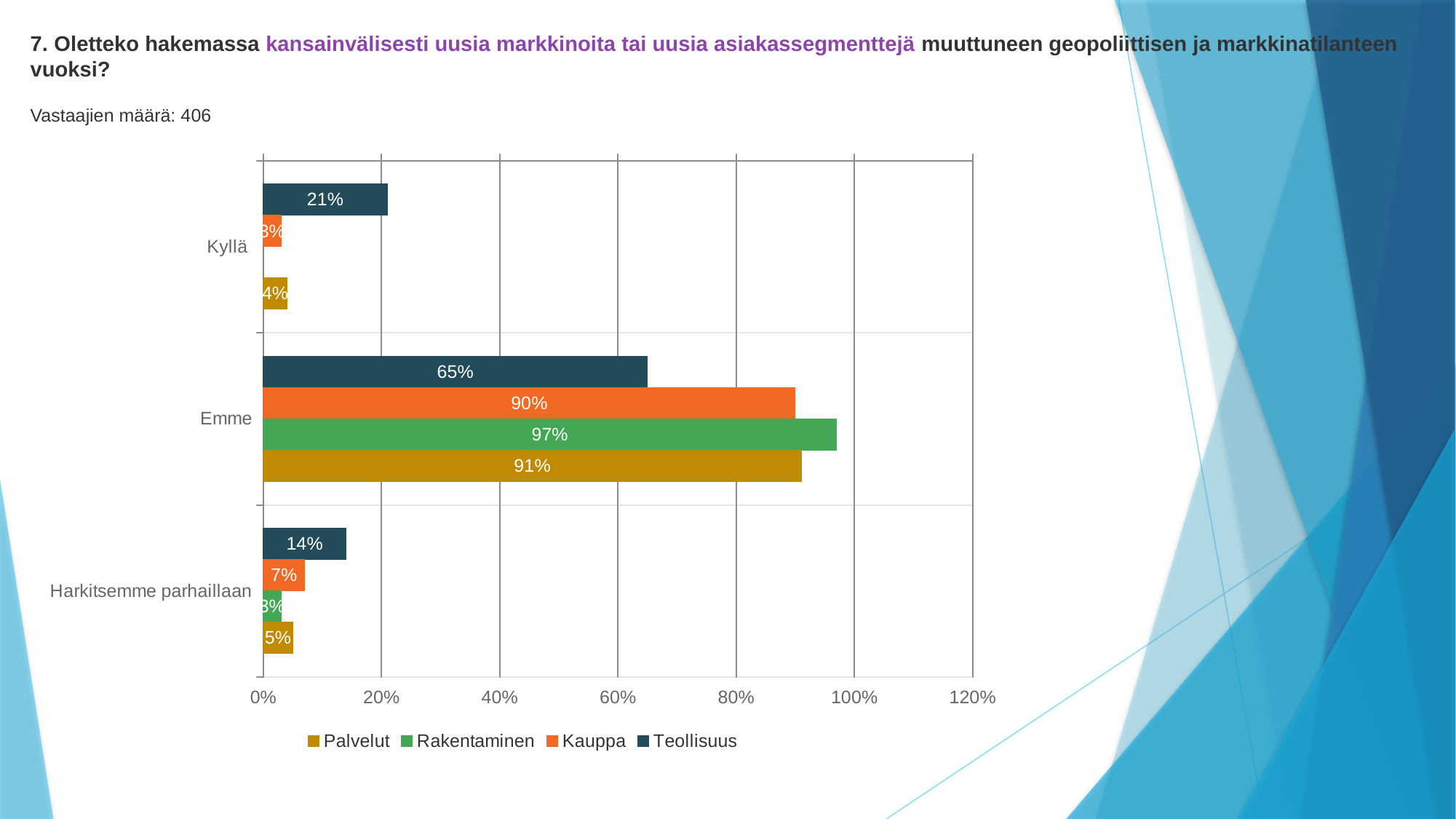
What kind of chart is shown on the slide? bar chart Which series is shown in orange in the legend? Kauppa How many categories are shown on the vertical axis? 3 What is the value for Teollisuus in the Kyllä category? 21% What is the value for Palvelut in the Emme category? 91% How many series does the legend list? 4 What is the value for Kauppa in the Harkitsemme parhaillaan category? 7% Is the value for Teollisuus in the Emme category greater or less than 60%? greater Which series has the highest value in the Emme category? Rakentaminen Which series has the lowest value in the Emme category? Teollisuus What is the difference between the Kauppa and Teollisuus values in the Emme category? 25% What is the value for Rakentaminen in the Emme category? 97%